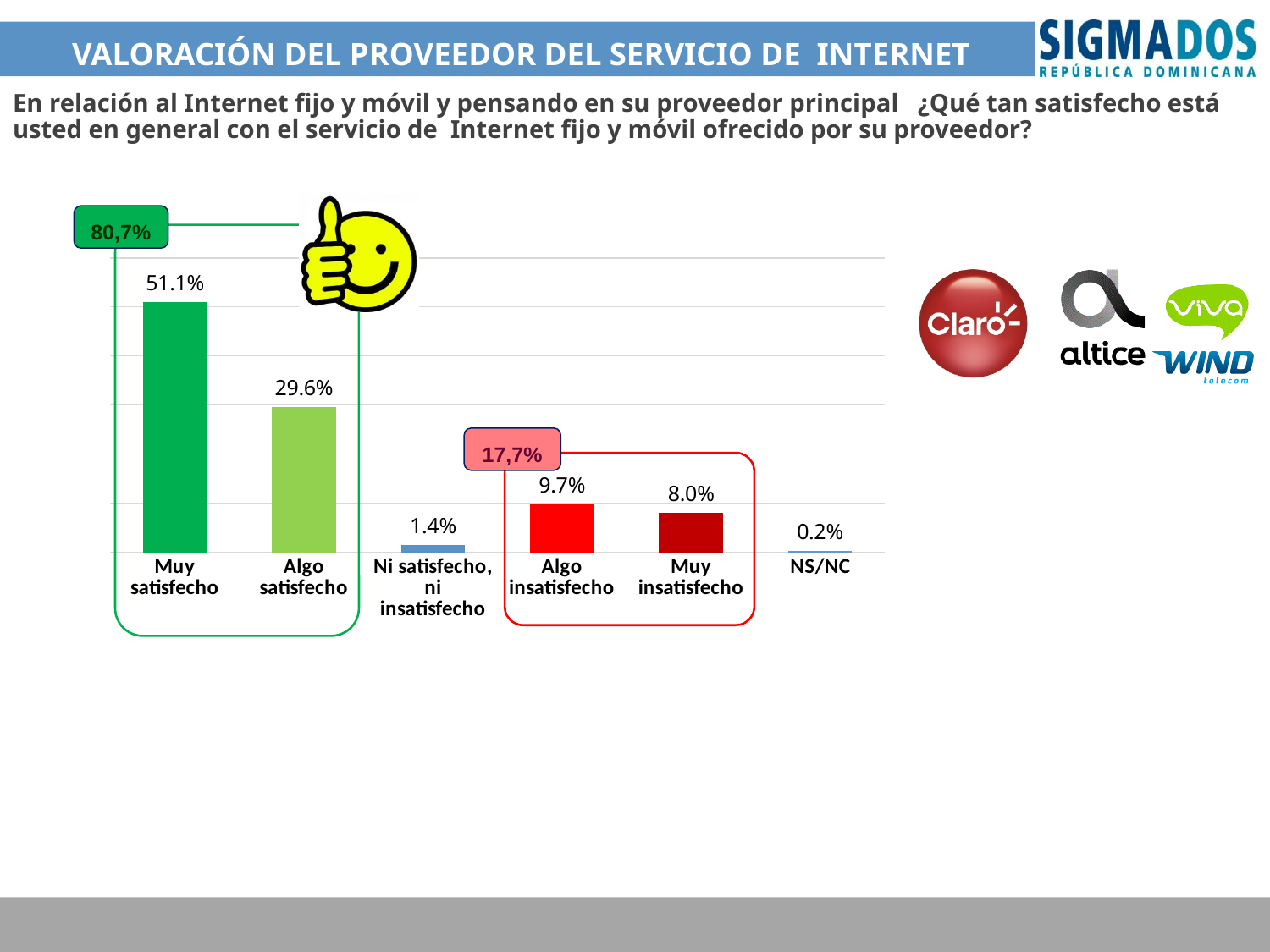
What is the value for "Algo satisfecho"? 29.6% How many categories are shown in the chart? 6 What is the value for "Ni satisfecho, ni insatisfecho"? 1.4% What is the value for "Muy insatisfecho"? 8.0% What is the value for "Muy satisfecho"? 51.1% What kind of chart is shown on the slide? Bar chart Which category has the lowest value? NS/NC What is the value for "NS/NC"? 0.2% What is the difference between the values for "Muy satisfecho" and "Algo satisfecho"? 21.5% What is the value for "Algo insatisfecho"? 9.7% Which is larger, the value for "Algo insatisfecho" or "Muy insatisfecho"? Algo insatisfecho Which category has the highest value? Muy satisfecho